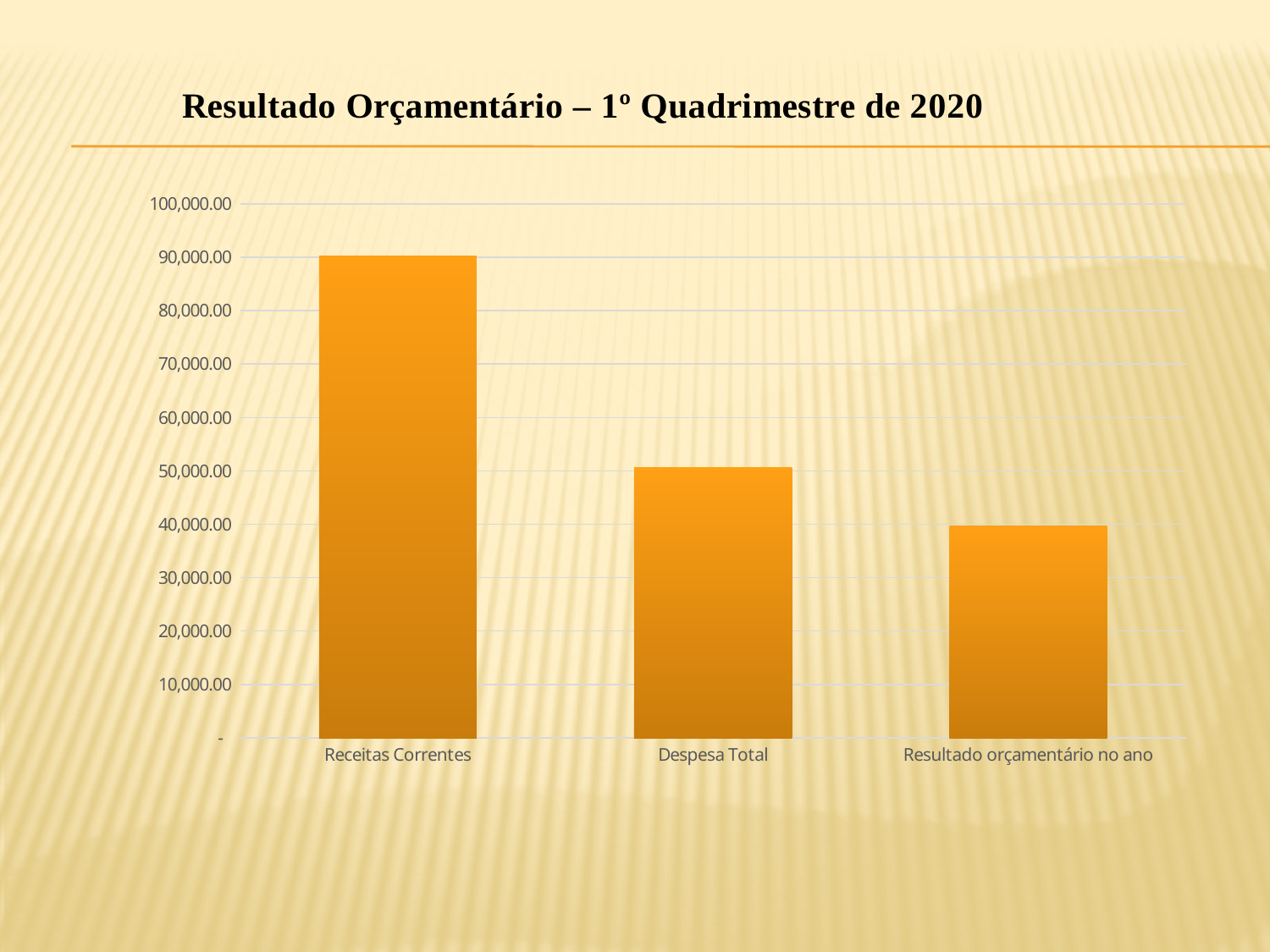
Do the bar values rise or fall from left to right across the categories? fall How many categories are plotted on the chart? 3 Which category has the lowest value? Resultado orçamentário no ano Which is larger, Despesa Total or Resultado orçamentário no ano? Despesa Total What kind of chart is shown on the slide? bar chart Is the value for Resultado orçamentário no ano greater or less than 50,000.00? less Is the value for Despesa Total greater or less than 60,000.00? less Is the value for Despesa Total greater or less than 40,000.00? greater Which category has the highest value? Receitas Correntes What is the title of the slide containing the chart? Resultado Orçamentário – 1º Quadrimestre de 2020 Which is larger, Receitas Correntes or Despesa Total? Receitas Correntes